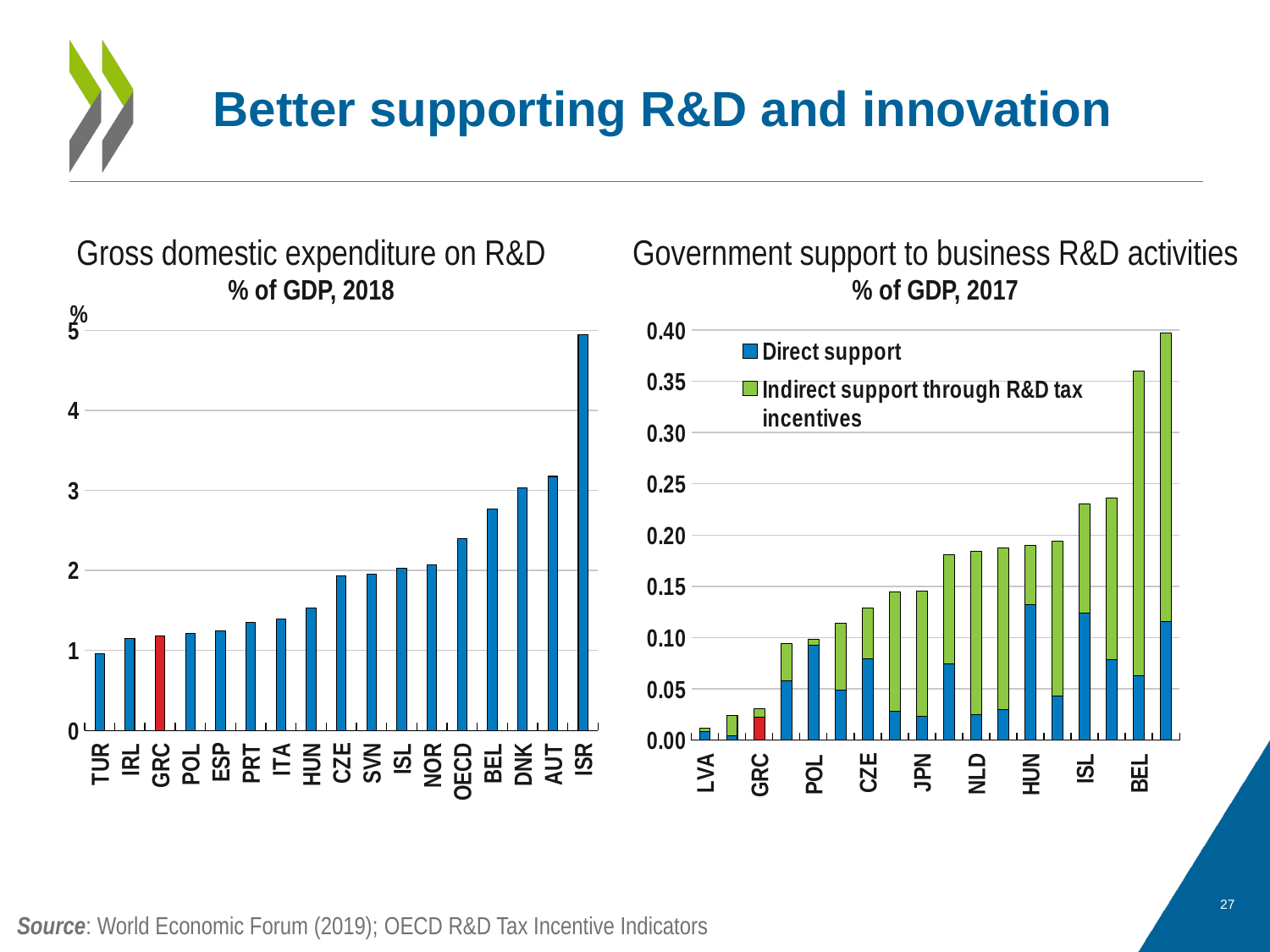
On the 'Government support to business R&D activities' chart, how many series does the legend list? 2 On the 'Gross domestic expenditure on R&D' chart, which country's bar is coloured red? GRC On the 'Gross domestic expenditure on R&D' chart, do the values rise or fall from left to right along the x axis? rise On the 'Government support to business R&D activities' chart, which is larger, the total for BEL or the total for ISL? BEL On the 'Gross domestic expenditure on R&D' chart, which country has the lowest value? TUR On the 'Gross domestic expenditure on R&D' chart, is the value for BEL greater or less than 3? less What kind of chart is the 'Government support to business R&D activities' chart? stacked bar chart On the 'Gross domestic expenditure on R&D' chart, is the value for ISR greater or less than 4? greater On the 'Gross domestic expenditure on R&D' chart, which country has the highest value? ISR On the 'Gross domestic expenditure on R&D' chart, which is larger, the value for ISR or the value for AUT? ISR On the 'Government support to business R&D activities' chart, is the total for BEL greater or less than 0.30? greater On the 'Gross domestic expenditure on R&D' chart, how many categories are shown on the x axis? 17